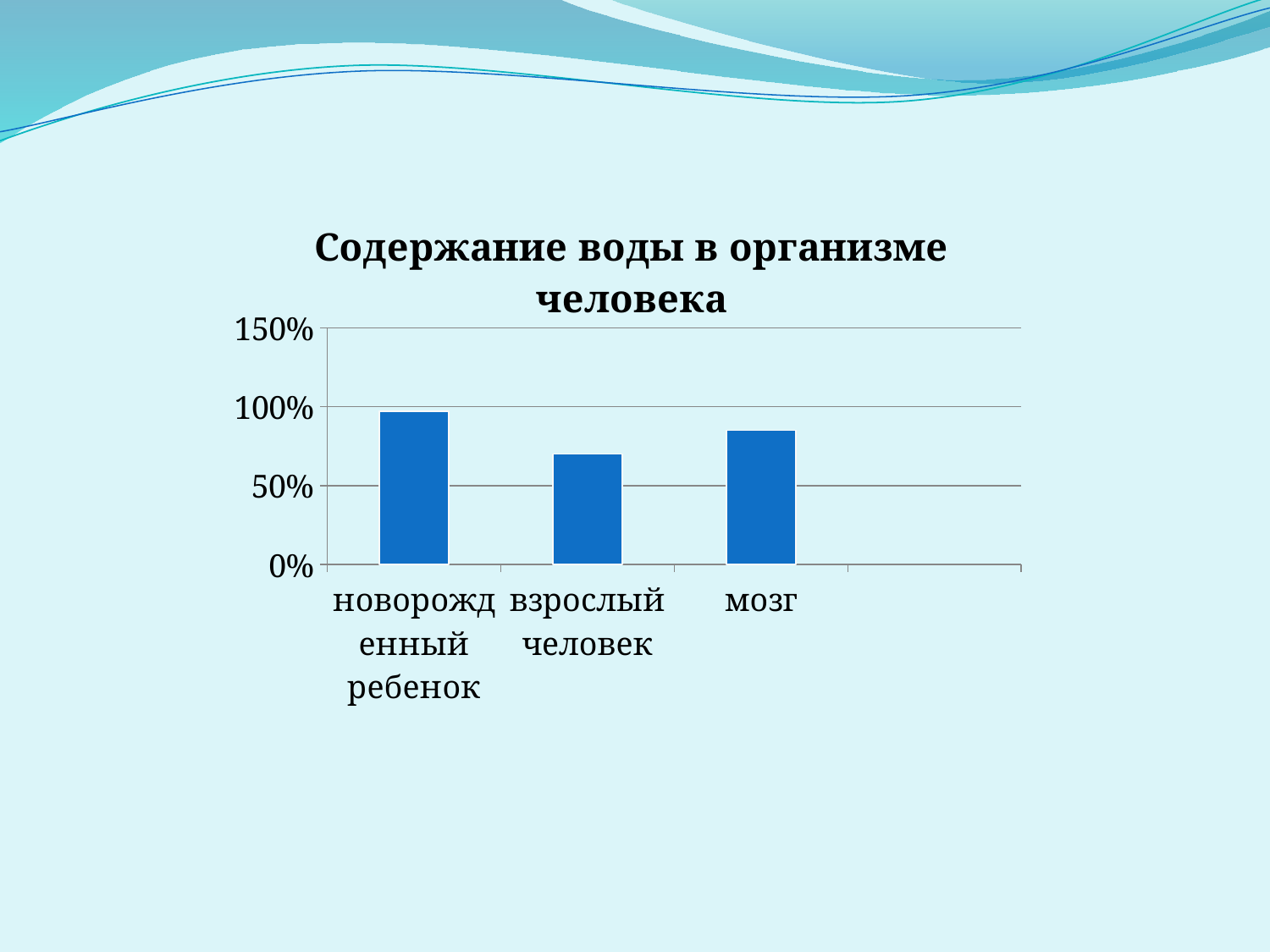
Is the value for взрослый человек greater or less than 50%? greater What is the highest value shown on the vertical axis? 150% How many categories are plotted in the chart? 3 Is the value for мозг greater or less than 100%? less What kind of chart is shown on the slide? bar chart Which category has the lowest value? взрослый человек Does the value fall or rise from новорожденный ребенок to взрослый человек? fall Which category has the highest value? новорожденный ребенок Which is larger, the value for новорожденный ребенок or the value for мозг? новорожденный ребенок Which is larger, the value for мозг or the value for взрослый человек? мозг What is the title of the chart? Содержание воды в организме человека